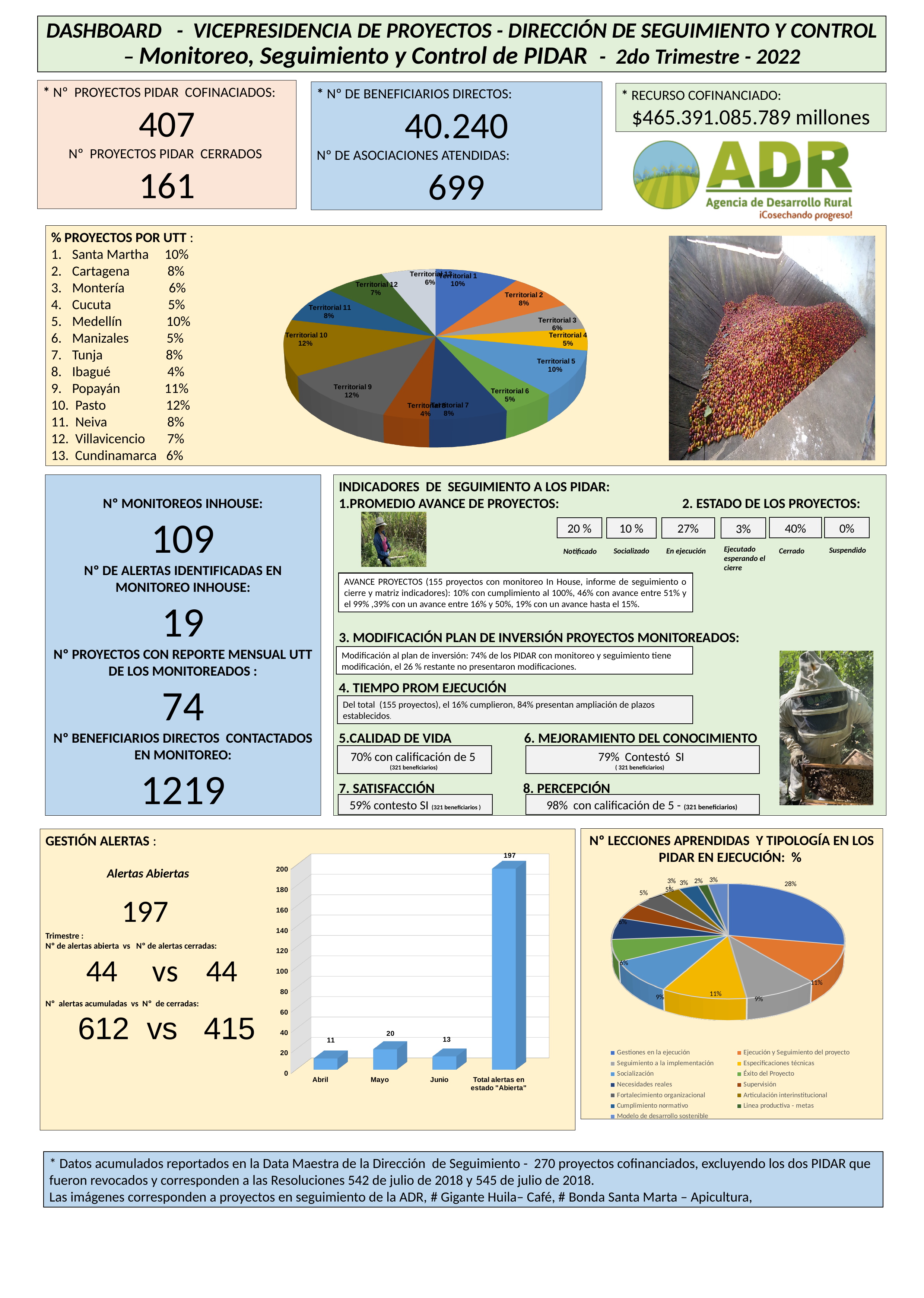
In the 'GESTIÓN ALERTAS' bar chart, what is the difference between the values for Mayo and Junio? 7 In the 'GESTIÓN ALERTAS' bar chart, what is the value for Mayo? 20 In the 'GESTIÓN ALERTAS' bar chart, which category has the highest value? Total alertas en estado "Abierta" In the '% PROYECTOS POR UTT' pie chart, what percentage is shown for Territorial 9? 12% In the 'N° LECCIONES APRENDIDAS Y TIPOLOGÍA' pie chart, what share does the largest slice have? 28% How many entries does the legend of the 'N° LECCIONES APRENDIDAS Y TIPOLOGÍA' pie chart list? 13 In the '% PROYECTOS POR UTT' pie chart, what is the difference between the shares of Territorial 10 and Territorial 12? 5% In the 'GESTIÓN ALERTAS' bar chart, which month has the lowest value? Abril In the '% PROYECTOS POR UTT' pie chart, which territorial has the smallest share? Territorial 8 In the 'GESTIÓN ALERTAS' bar chart, is the value for Total alertas en estado "Abierta" greater or less than 180? greater What kind of chart is used in the 'GESTIÓN ALERTAS' section? bar chart How many territorial slices does the '% PROYECTOS POR UTT' pie chart have? 13